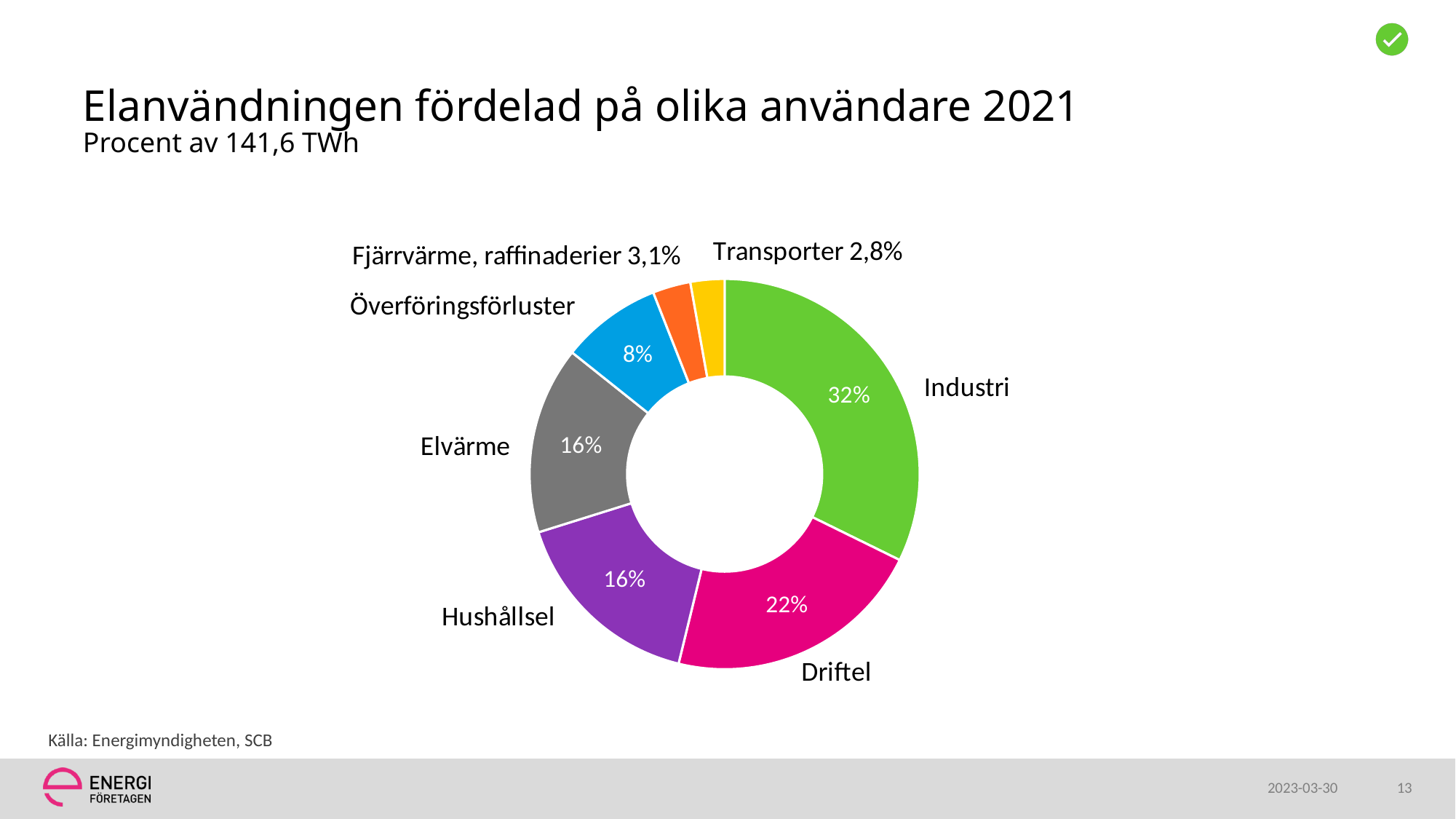
What percentage is shown for Överföringsförluster? 8% What is the value for Fjärrvärme, raffinaderier? 3,1% Which category has the smallest share of the chart? Transporter What share of electricity use does Industri account for? 32% What kind of chart is shown on the slide? Doughnut (pie) chart How many categories are shown in the chart? 7 What is the title of the chart on the slide? Elanvändningen fördelad på olika användare 2021 Which is larger, the share for Driftel or the share for Hushållsel? Driftel Which category has the largest share of the chart? Industri What is the difference in percentage points between Industri and Driftel? 10 What is the value shown for Driftel? 22% What is the value for Transporter? 2,8%